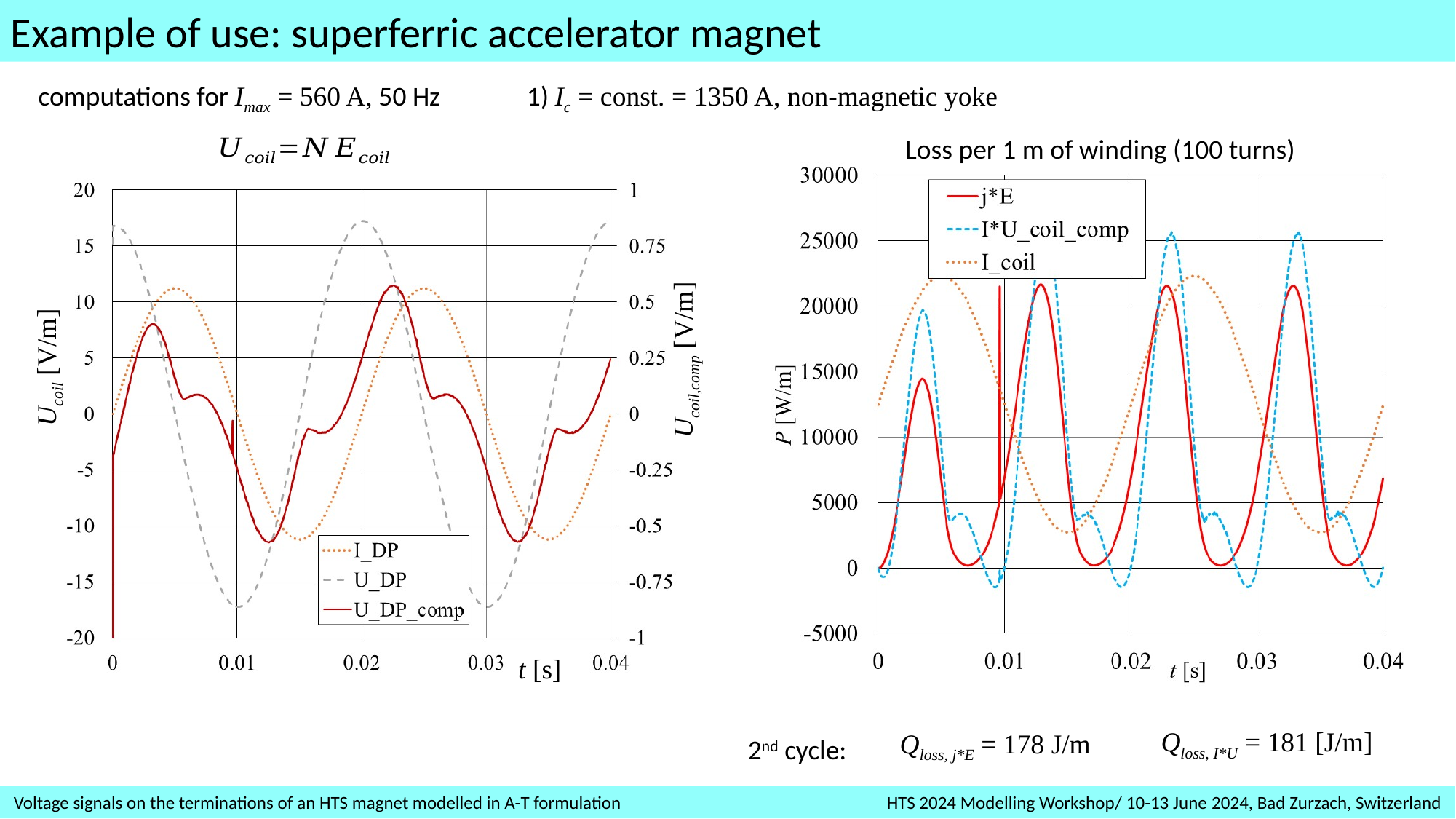
What is the maximum value shown on the vertical axis of the chart titled "Loss per 1 m of winding (100 turns)"? 30000 What kind of chart is the left chart (U_coil versus t)? line chart In the chart titled "Loss per 1 m of winding (100 turns)", which series is drawn as a dashed blue line? I*U_coil_comp In the left chart, is the peak value of the U_DP series on the left axis greater or less than 15? greater How many series does the legend of the left chart list? 3 What is the maximum value shown on the horizontal time axis of the left chart? 0.04 How many series does the legend of the chart titled "Loss per 1 m of winding (100 turns)" list? 3 What kind of chart is the chart titled "Loss per 1 m of winding (100 turns)"? line chart In the left chart, is the peak value of the U_DP_comp series on the left axis greater or less than 10? greater In the chart titled "Loss per 1 m of winding (100 turns)", is the minimum value of the I*U_coil_comp series greater or less than 0? less In the left chart, which series is drawn as a solid red line? U_DP_comp